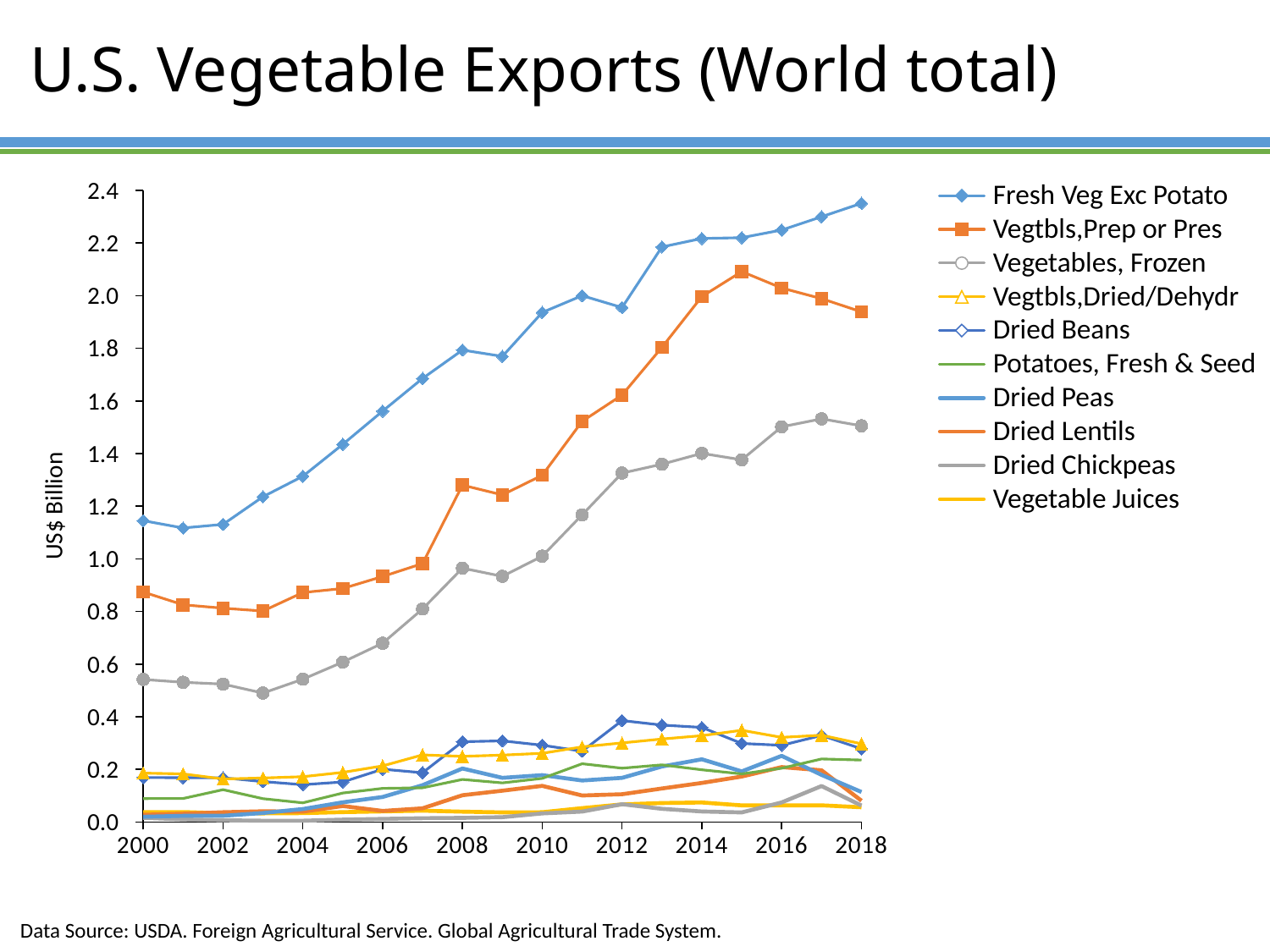
Is the value for Fresh Veg Exc Potato in 2008 greater or less than 1.6? greater How many years are plotted along the x axis, from 2000 to 2018? 19 Does the Fresh Veg Exc Potato series generally rise or fall from 2000 to 2018? rise Which series has the highest value in 2018? Fresh Veg Exc Potato How many series does the legend list? 10 Is the value for Vegetables, Frozen in 2000 greater or less than 0.6? less Is the value for Fresh Veg Exc Potato in 2018 greater or less than 2.2? greater What is the label on the y axis? US$ Billion What type of chart is shown on the slide? line chart What is the title of the chart? U.S. Vegetable Exports (World total) Does the Vegtbls,Prep or Pres series rise or fall from 2015 to 2018? fall In 2018, which is larger: Vegtbls,Prep or Pres or Vegetables, Frozen? Vegtbls,Prep or Pres